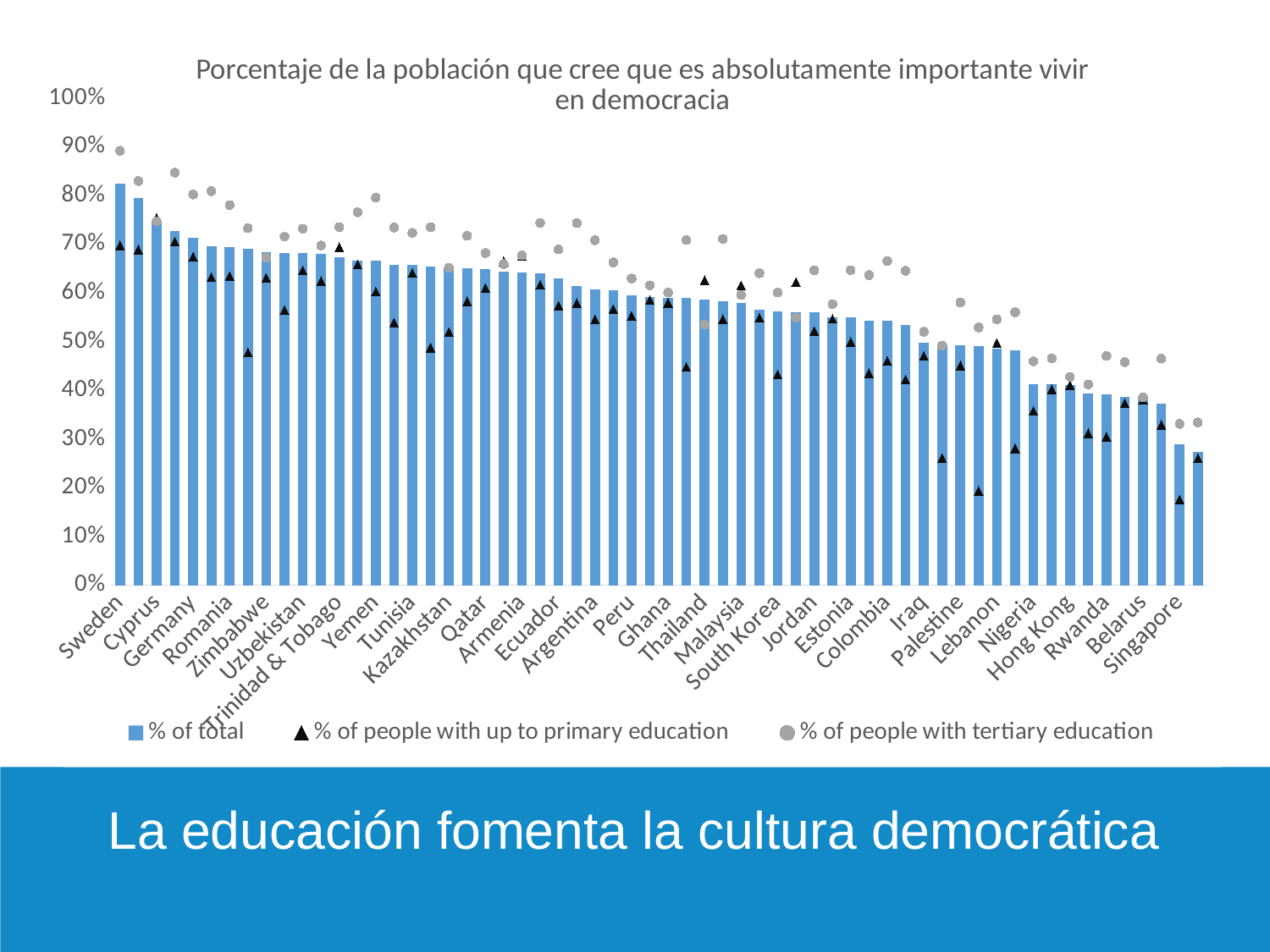
Is the % of total value for Sweden greater or less than 80%? greater Do the % of total bars rise or fall from left to right along the x axis? Fall Is the % of total value for Cyprus greater or less than 70%? greater Which series is shown with black triangle markers? % of people with up to primary education Which has the larger % of total bar, Germany or Nigeria? Germany How many series does the legend list? 3 What is the title of the chart? Porcentaje de la población que cree que es absolutamente importante vivir en democracia Which has the larger % of total bar, Sweden or Singapore? Sweden What kind of chart is shown on the slide? Bar chart Which labeled country has the highest bar for % of total? Sweden Is the % of total value for Nigeria greater or less than 50%? less